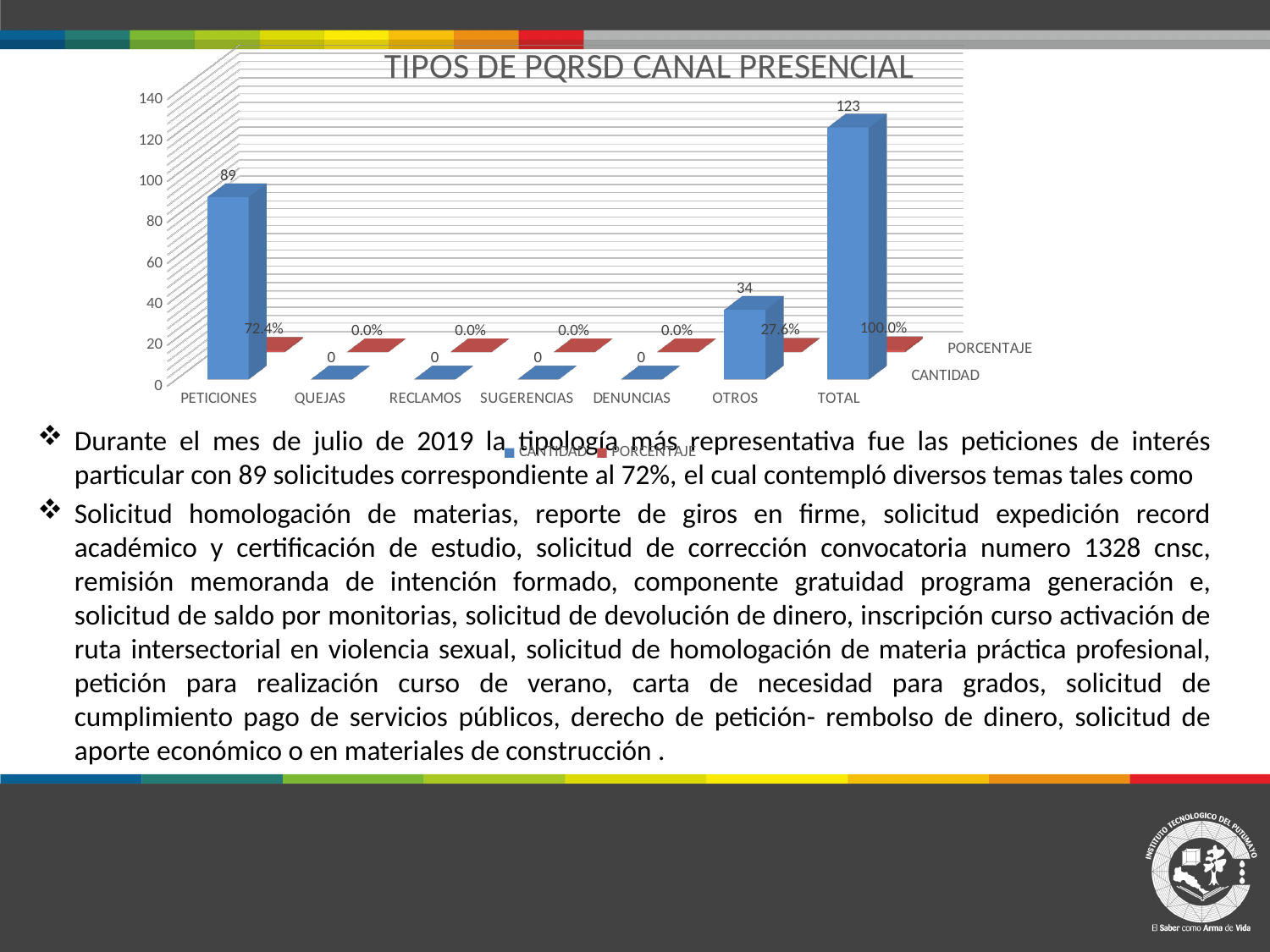
Which is larger, the CANTIDAD value for OTROS or for PETICIONES? PETICIONES What is the CANTIDAD value for OTROS? 34 How many series does the legend list? 2 What is the title of the chart? TIPOS DE PQRSD CANAL PRESENCIAL What is the difference between the CANTIDAD values for PETICIONES and OTROS? 55 What is the CANTIDAD value for TOTAL? 123 How many categories are shown on the x axis? 7 What is the PORCENTAJE value for PETICIONES? 72.4% What is the PORCENTAJE value for OTROS? 27.6% Excluding TOTAL, which category has the highest CANTIDAD value? PETICIONES What is the CANTIDAD value for PETICIONES? 89 What is the CANTIDAD value for QUEJAS? 0